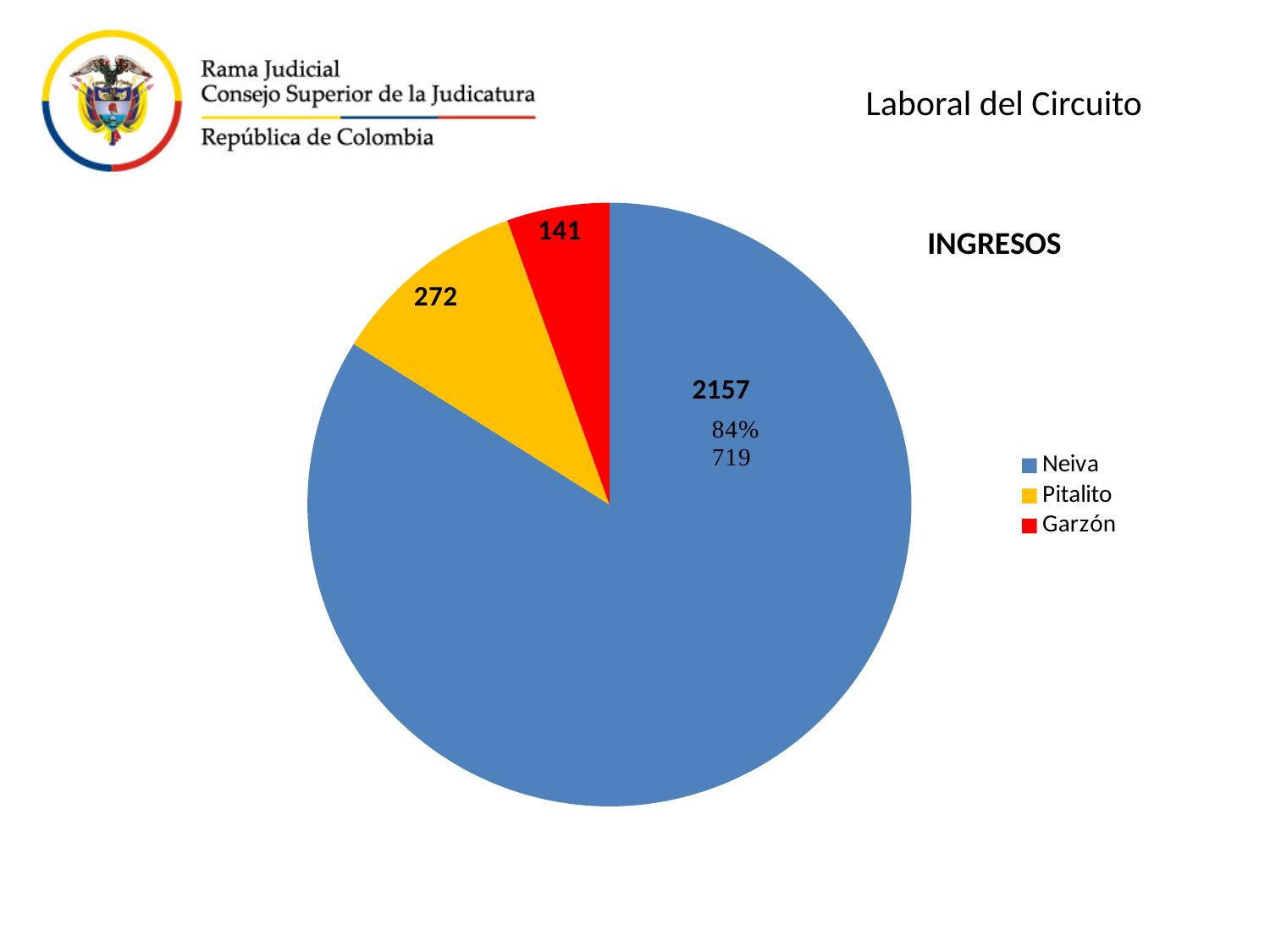
What is the value for Garzón? 141 What is the difference between the values for Neiva and Pitalito? 1885 Which is larger, the value for Pitalito or the value for Garzón? Pitalito What colour is the slice for Garzón? red What is the value for Pitalito? 272 What is the title of the chart? INGRESOS What is the difference between the values for Pitalito and Garzón? 131 What is the value for Neiva? 2157 Which category has the largest slice of the pie? Neiva Which category has the smallest slice of the pie? Garzón What kind of chart is shown on the slide? pie chart How many categories does the legend list? 3